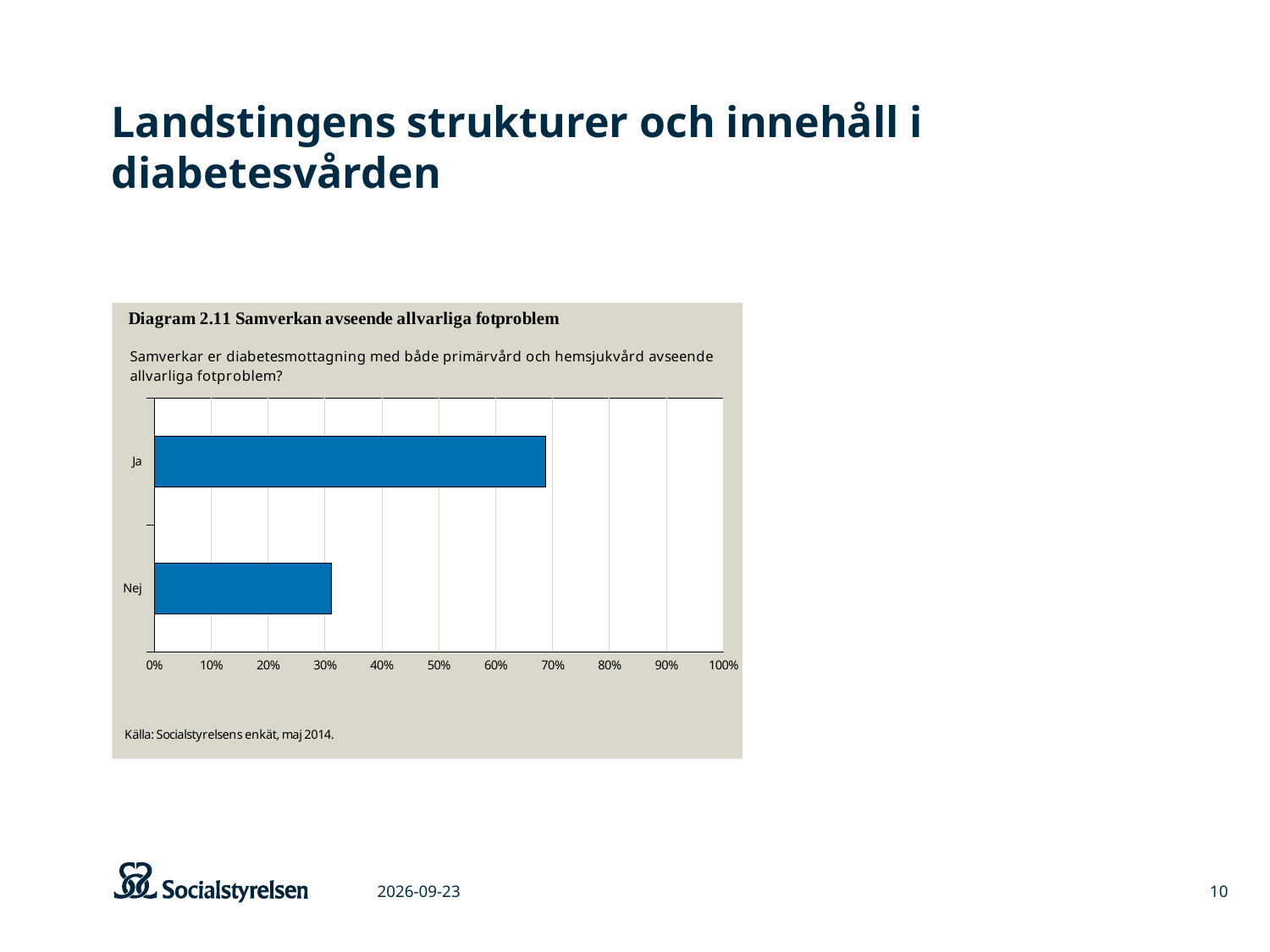
Which is larger, the value for Ja or the value for Nej? Ja What is the highest value shown on the x axis of the chart? 100% Is the value for Ja greater or less than 60%? greater What is the title of the diagram on the slide? Diagram 2.11 Samverkan avseende allvarliga fotproblem How many categories are plotted in Diagram 2.11? 2 Which category has the highest value in Diagram 2.11? Ja Is the value for Nej greater or less than 40%? less What kind of chart is shown in Diagram 2.11? bar chart Is the value for Ja greater or less than 80%? less Which category has the lowest value in Diagram 2.11? Nej